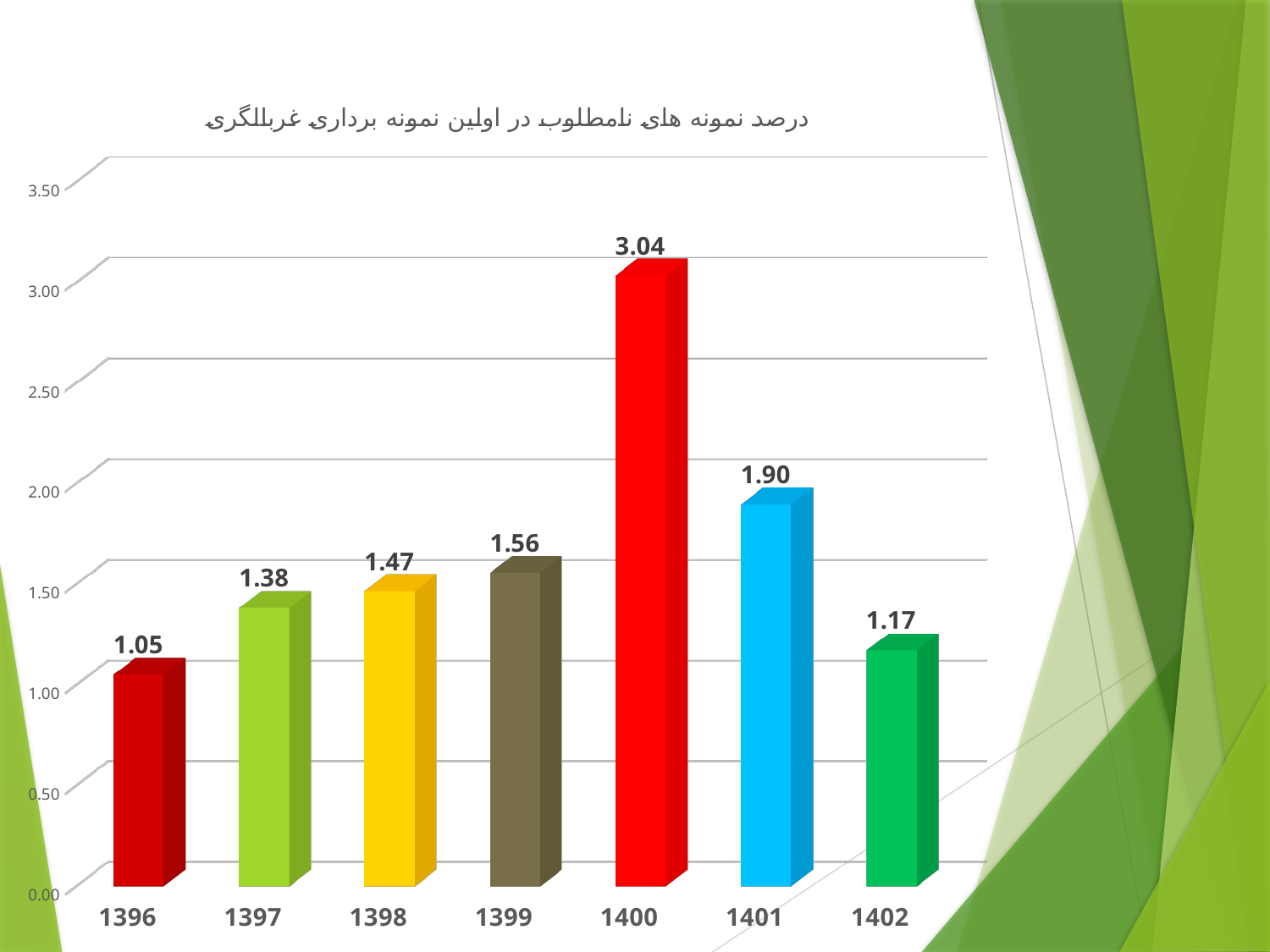
What kind of chart is this? bar chart What is the value for 1400? 3.04 Which year has the lowest value? 1396 What is the difference between the values for 1400 and 1401? 1.14 What is the difference between the values for 1399 and 1398? 0.09 Which year has the highest value? 1400 What is the value for 1402? 1.17 Do the values rise or fall from 1396 to 1399? rise How many years are shown on the x axis? 7 Is the value for 1400 greater or less than 3.00? greater What is the value for 1396? 1.05 Which is larger, the value for 1401 or the value for 1402? 1401